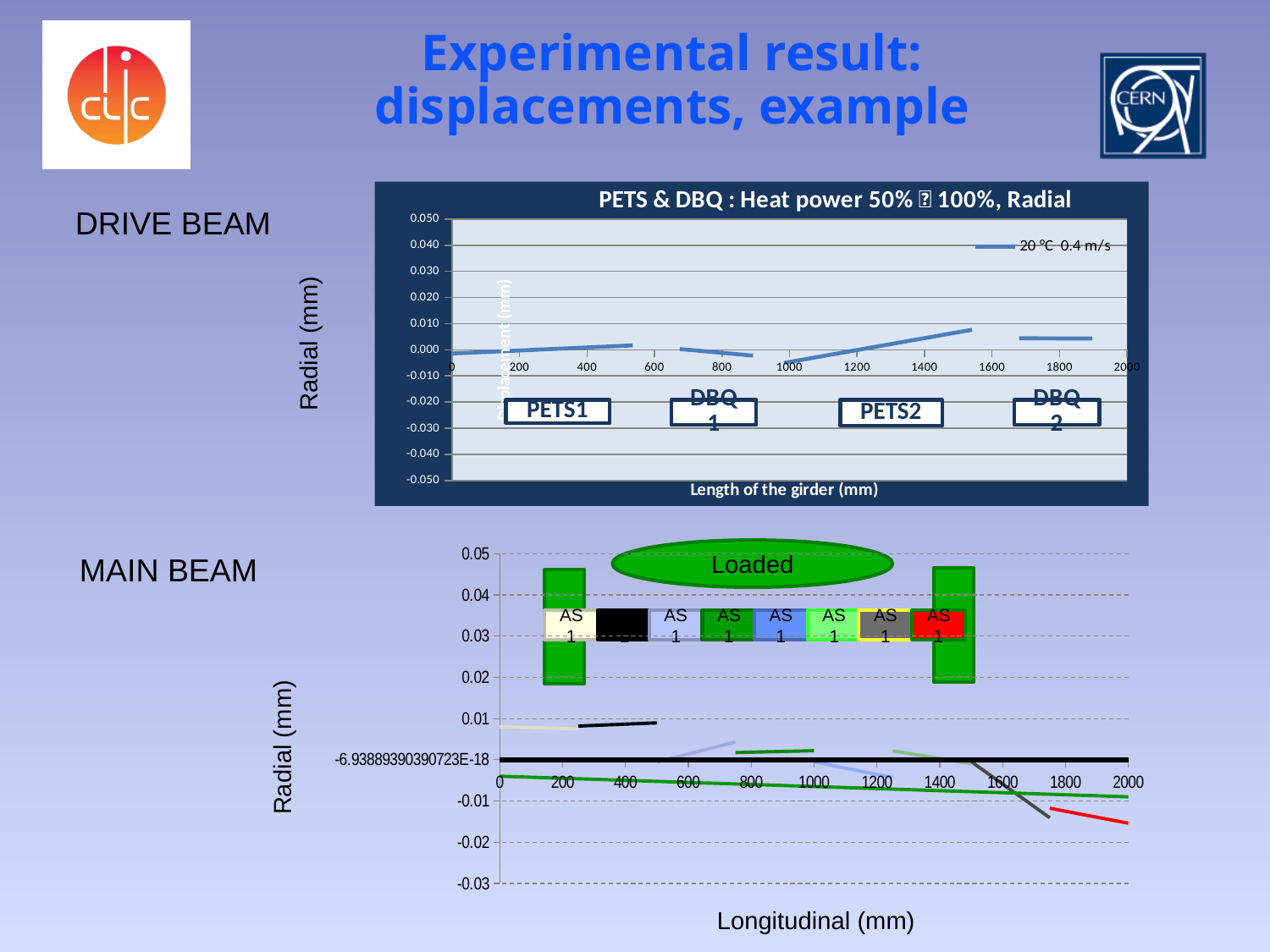
In the top chart, is the value at 1800 mm greater or less than 0.020? less In the top chart, does the line rise or fall between 1100 mm and 1500 mm? rise In the top chart, is the value at 1400 mm greater or less than 0.000? greater In the top chart, what is the x-axis title? Length of the girder (mm) What kind of chart is the top chart (DRIVE BEAM)? line chart In the bottom chart, what is the x-axis title? Longitudinal (mm) What is the legend entry in the top chart? 20 °C 0.4 m/s What is the title of the top chart? PETS & DBQ : Heat power 50% 100%, Radial What kind of chart is the bottom chart (MAIN BEAM)? line chart How many series does the legend of the top chart list? 1 In the bottom chart, is the value of the red line at 2000 mm greater or less than -0.01? less In the top chart, what is the highest value shown on the y-axis? 0.050